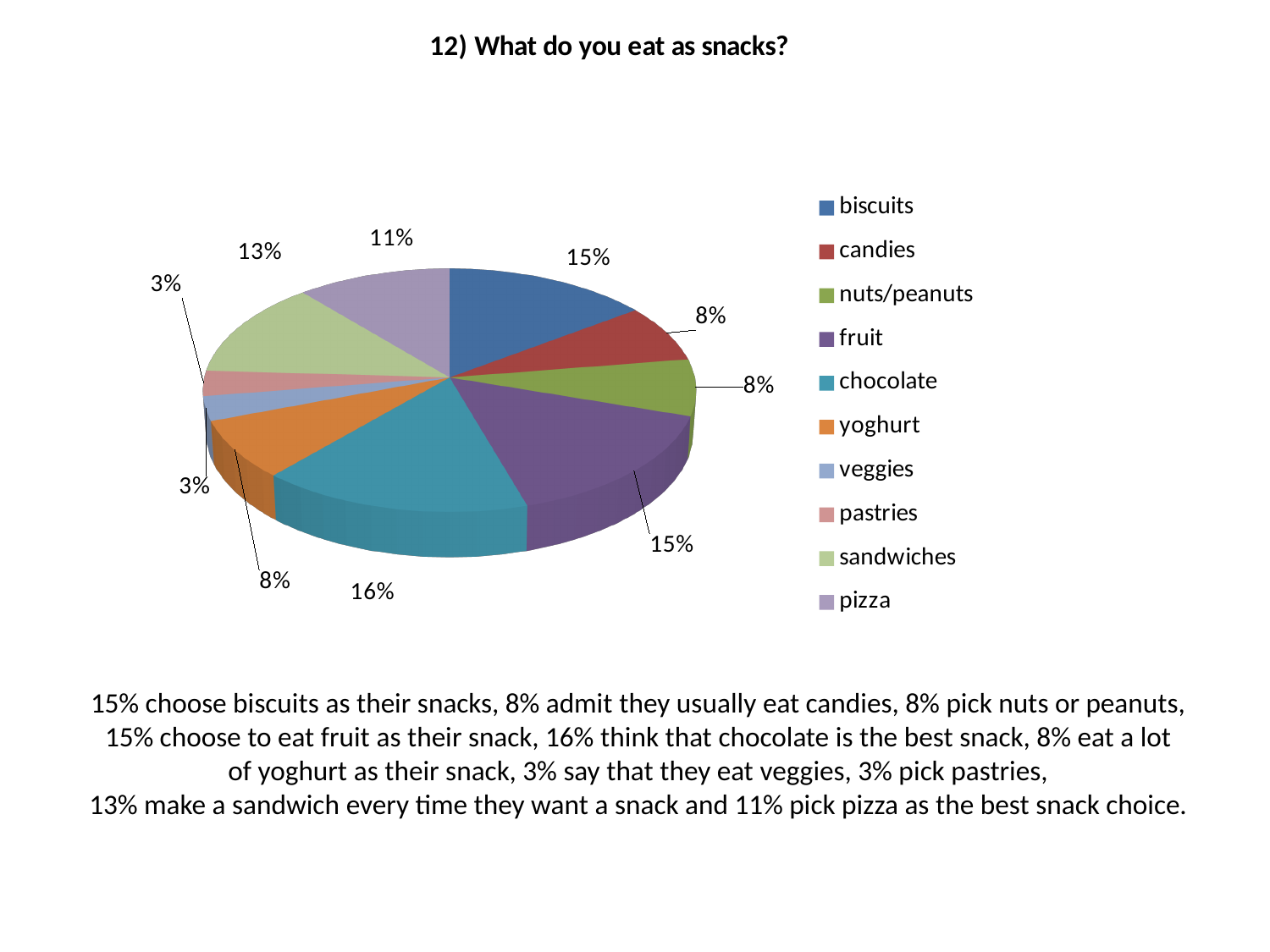
What is the title of the chart? 12) What do you eat as snacks? What share of the pie does chocolate have? 16% What kind of chart is shown on the slide? pie chart Which is larger, the share for sandwiches or the share for candies? sandwiches Which snack has the largest slice of the pie? chocolate What is the combined share of veggies and pastries? 6% What share of the pie does pizza have? 11% How many categories does the legend list? 10 What share of the pie does sandwiches have? 13% What is the difference between the shares for chocolate and pizza? 5%